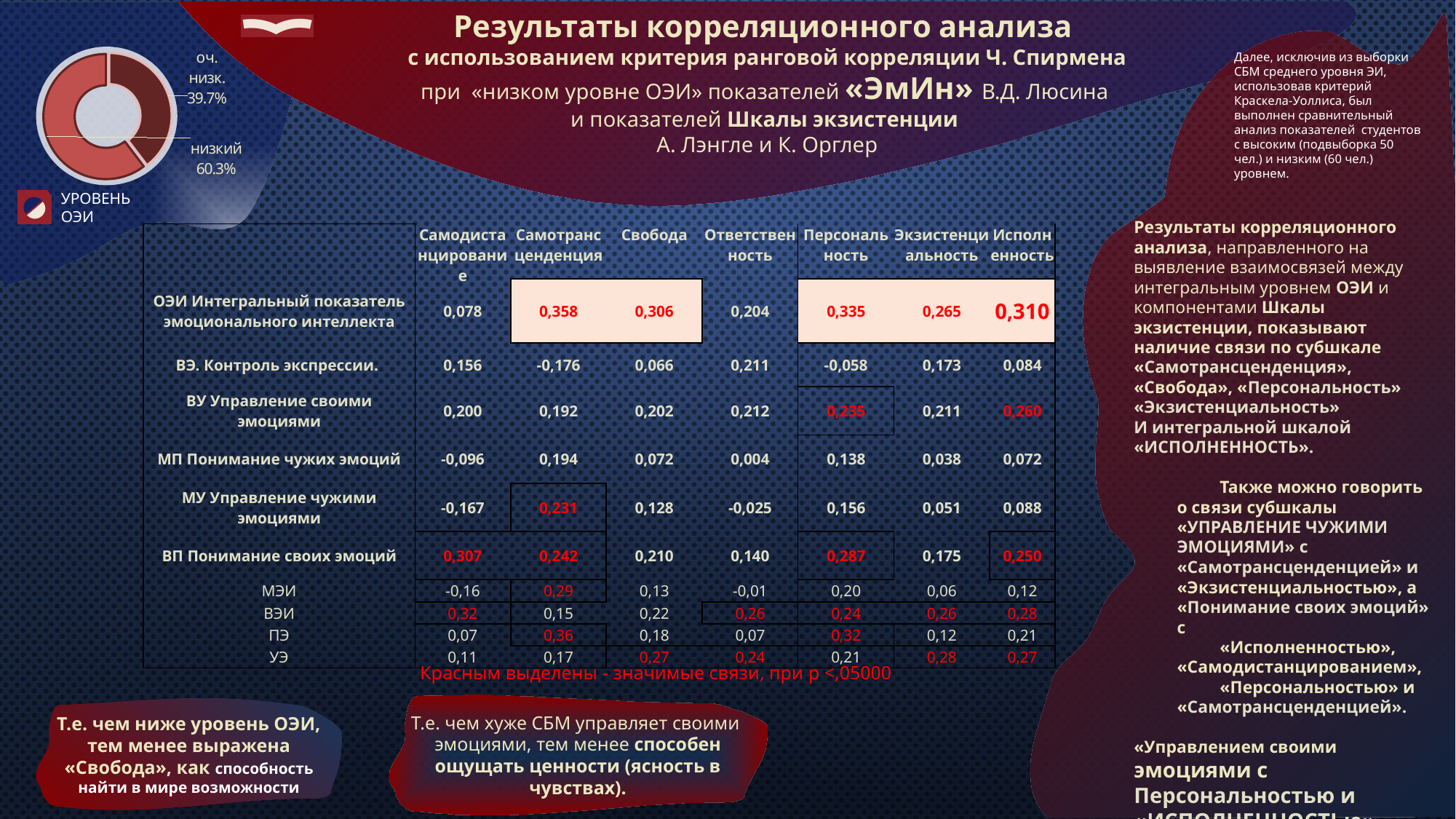
What share of the doughnut chart does the "оч. низк." slice represent? 39.7% How many slices does the doughnut chart have? 2 Is the share of the "оч. низк." slice in the doughnut chart greater or less than 50%? less Which slice of the doughnut chart is the largest? низкий What is the total of the two slices shown in the doughnut chart? 100% Which slice of the doughnut chart is the smallest? оч. низк. Is the share of the "низкий" slice in the doughnut chart greater or less than 50%? greater What kind of chart is shown in the top-left corner of the slide? Doughnut chart What is the difference in percentage points between the "низкий" and "оч. низк." slices of the doughnut chart? 20.6% In the doughnut chart, which is larger: "низкий" or "оч. низк."? низкий What is the label shown beneath the doughnut chart? УРОВЕНЬ ОЭИ What share of the doughnut chart does the "низкий" slice represent? 60.3%